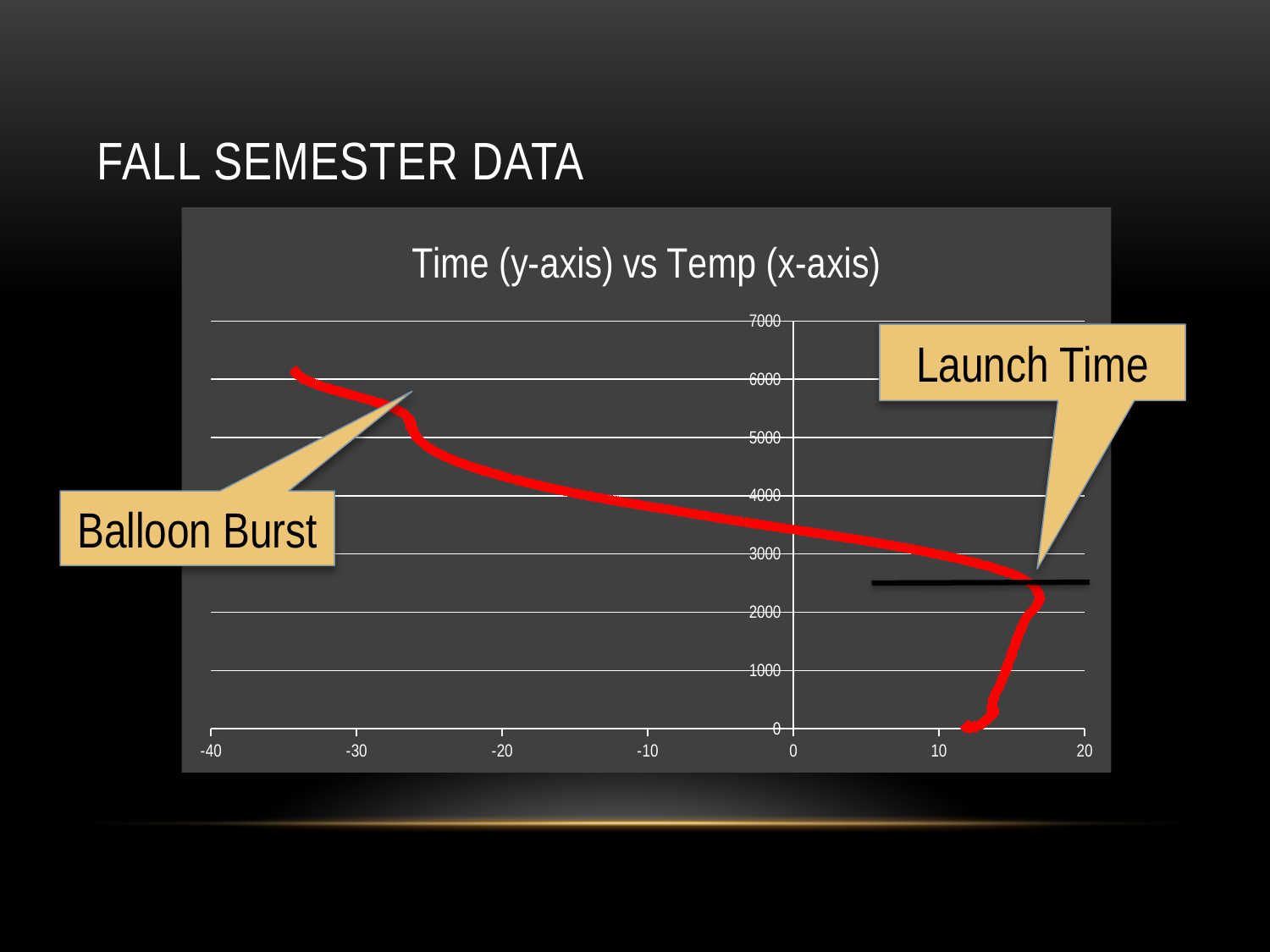
What is the highest value shown on the y axis? 7000 Is the time value at the lowest point of the curve greater or less than 1000? less Is the temperature at the point labelled Launch Time greater or less than 10? greater Is the time value at the point labelled Balloon Burst greater or less than 5000? greater What is the title of the chart? Time (y-axis) vs Temp (x-axis) What kind of chart is shown on the slide? line chart Does the temperature rise or fall as time increases from Launch Time to Balloon Burst? fall Which labelled event occurs at the larger time value, Balloon Burst or Launch Time? Balloon Burst Which labelled event has the higher temperature, Balloon Burst or Launch Time? Launch Time What two events are labelled with callouts on the chart? Balloon Burst and Launch Time